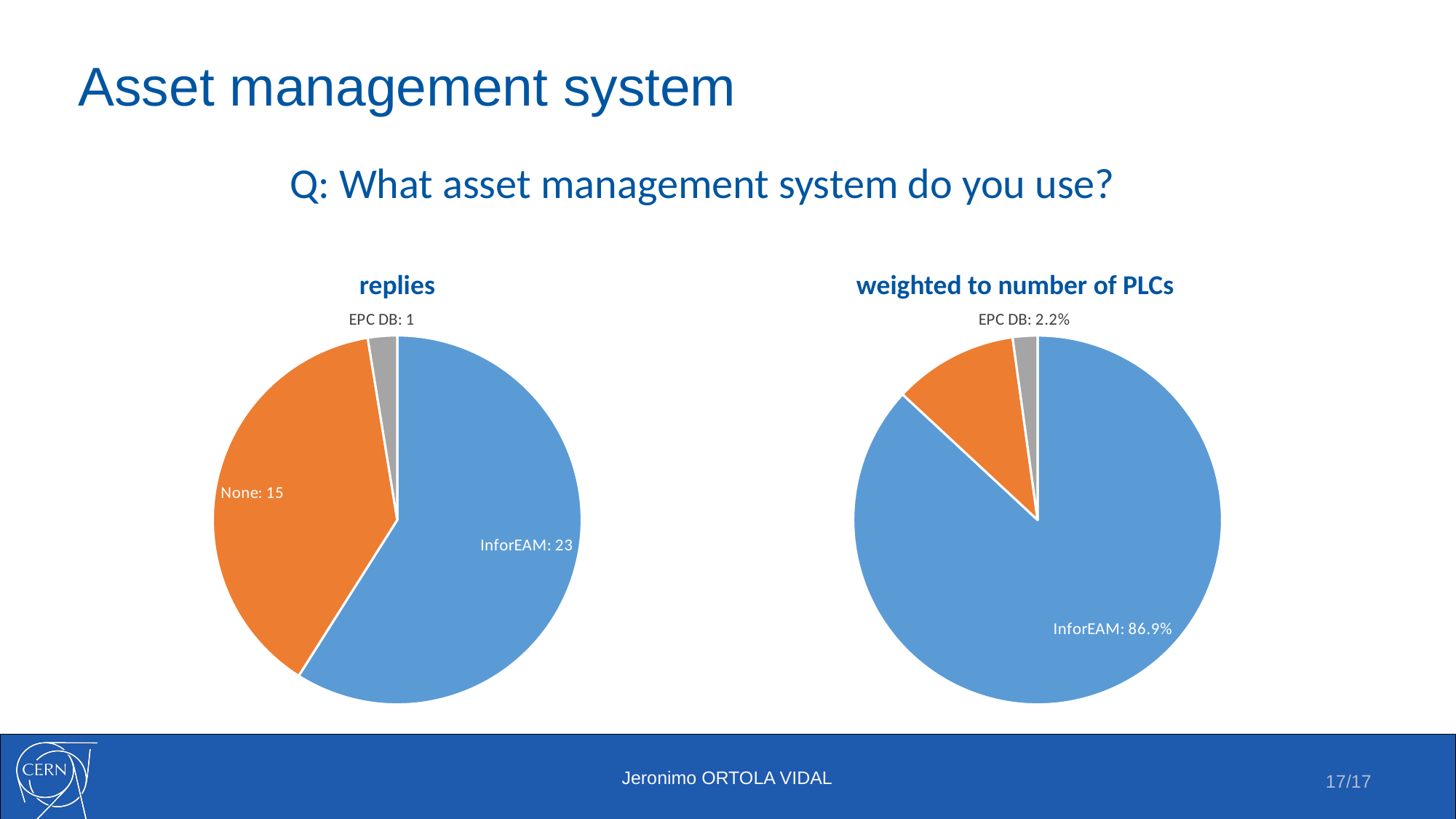
How many slices does the "replies" pie chart have? 3 In the "replies" pie chart, how many more replies does InforEAM have than None? 8 In the "replies" pie chart, which category has the most replies? InforEAM In the "replies" pie chart, which has more replies, None or EPC DB? None In the "weighted to number of PLCs" pie chart, what is the share for InforEAM? 86.9% In the "replies" pie chart, how many replies are for InforEAM? 23 What kind of chart is the "weighted to number of PLCs" chart? Pie chart What is the title of the pie chart on the right of the slide? weighted to number of PLCs In the "weighted to number of PLCs" pie chart, what is the share for EPC DB? 2.2% In the "replies" pie chart, which category has the fewest replies? EPC DB In the "replies" pie chart, how many replies are for EPC DB? 1 In the "replies" pie chart, how many replies are for None? 15